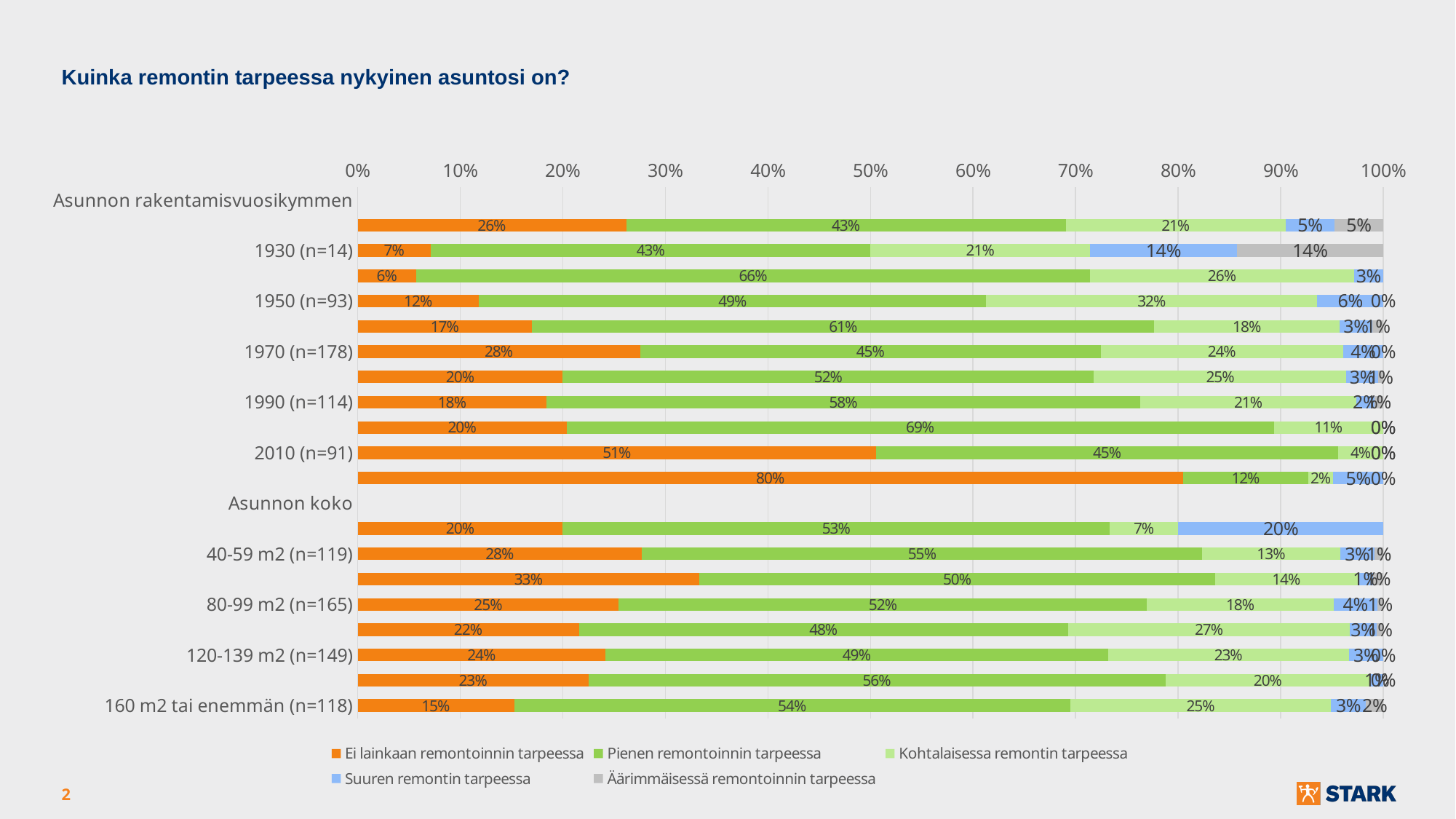
What is the value of "Suuren remontin tarpeessa" for 1930 (n=14)? 14% What is the value of "Ei lainkaan remontoinnin tarpeessa" for 160 m2 tai enemmän (n=118)? 15% What is the value of "Pienen remontoinnin tarpeessa" for 1990 (n=114)? 58% What is the difference between "Kohtalaisessa remontin tarpeessa" for 80-99 m2 (n=165) and for 120-139 m2 (n=149)? 5% How many series does the legend list? 5 What is the value of "Ei lainkaan remontoinnin tarpeessa" for 2010 (n=91)? 51% What kind of chart is shown on the slide? Stacked bar chart Which series has the largest share in the 1930 (n=14) bar? Pienen remontoinnin tarpeessa Which is larger: "Ei lainkaan remontoinnin tarpeessa" for 1970 (n=178) or for 1990 (n=114)? 1970 (n=178) What is the value of "Pienen remontoinnin tarpeessa" for 40-59 m2 (n=119)? 55% What is the title of the chart? Kuinka remontin tarpeessa nykyinen asuntosi on? What is the value of "Kohtalaisessa remontin tarpeessa" for 1950 (n=93)? 32%